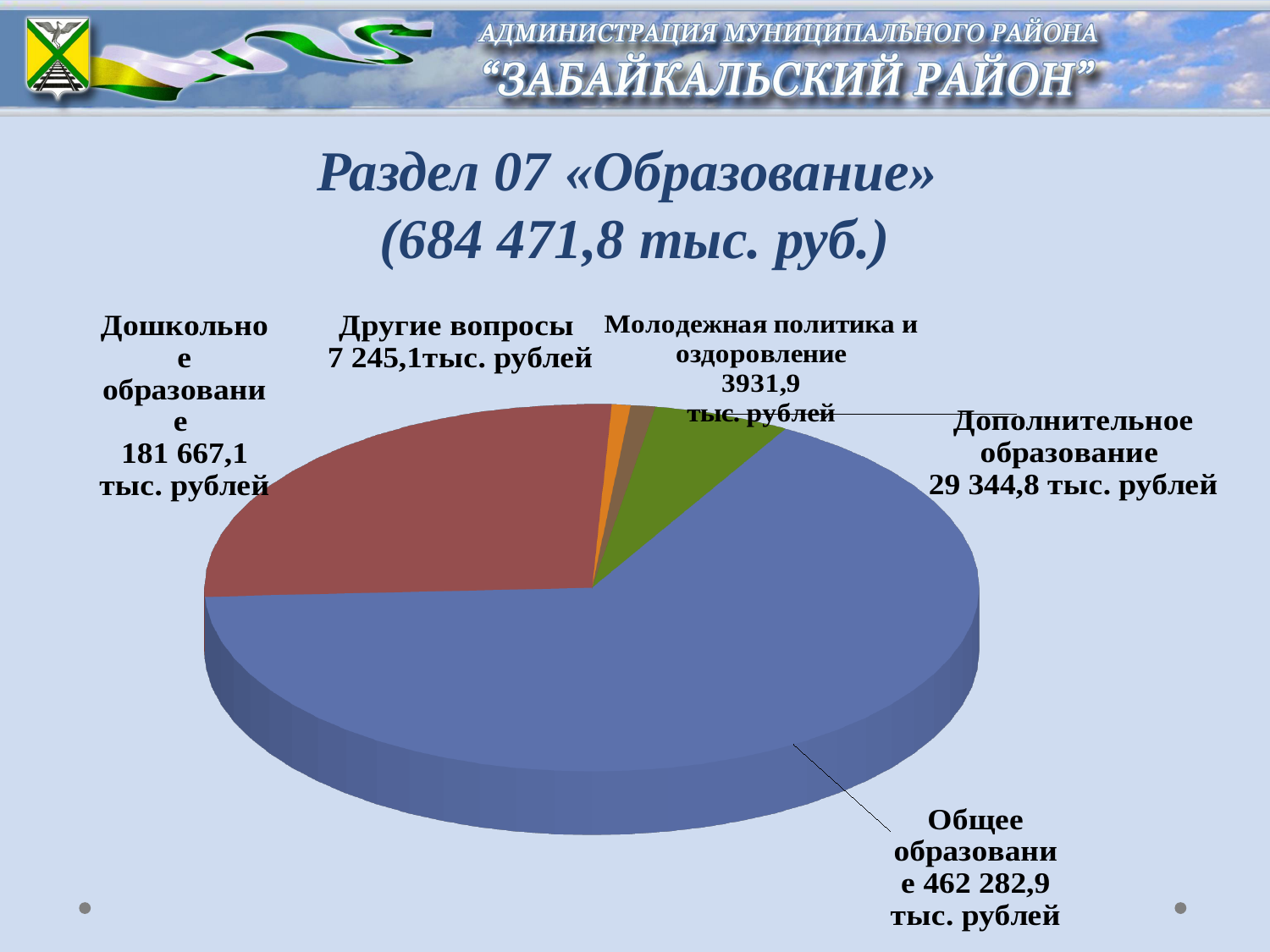
What is the value for Дополнительное образование? 29 344,8 тыс. рублей What total amount is given in the chart title for Раздел 07 «Образование»? 684 471,8 тыс. руб. How many slices does the pie chart have? 5 Which category has the largest slice of the pie? Общее образование What is the difference between Дополнительное образование and Другие вопросы? 22 099,7 тыс. рублей What is the value for Общее образование? 462 282,9 тыс. рублей What is the value for Молодежная политика и оздоровление? 3931,9 тыс. рублей What kind of chart is shown on the slide? Pie chart What is the difference between Общее образование and Дошкольное образование? 280 615,8 тыс. рублей Which is larger, Дошкольное образование or Дополнительное образование? Дошкольное образование What is the value for Дошкольное образование? 181 667,1 тыс. рублей